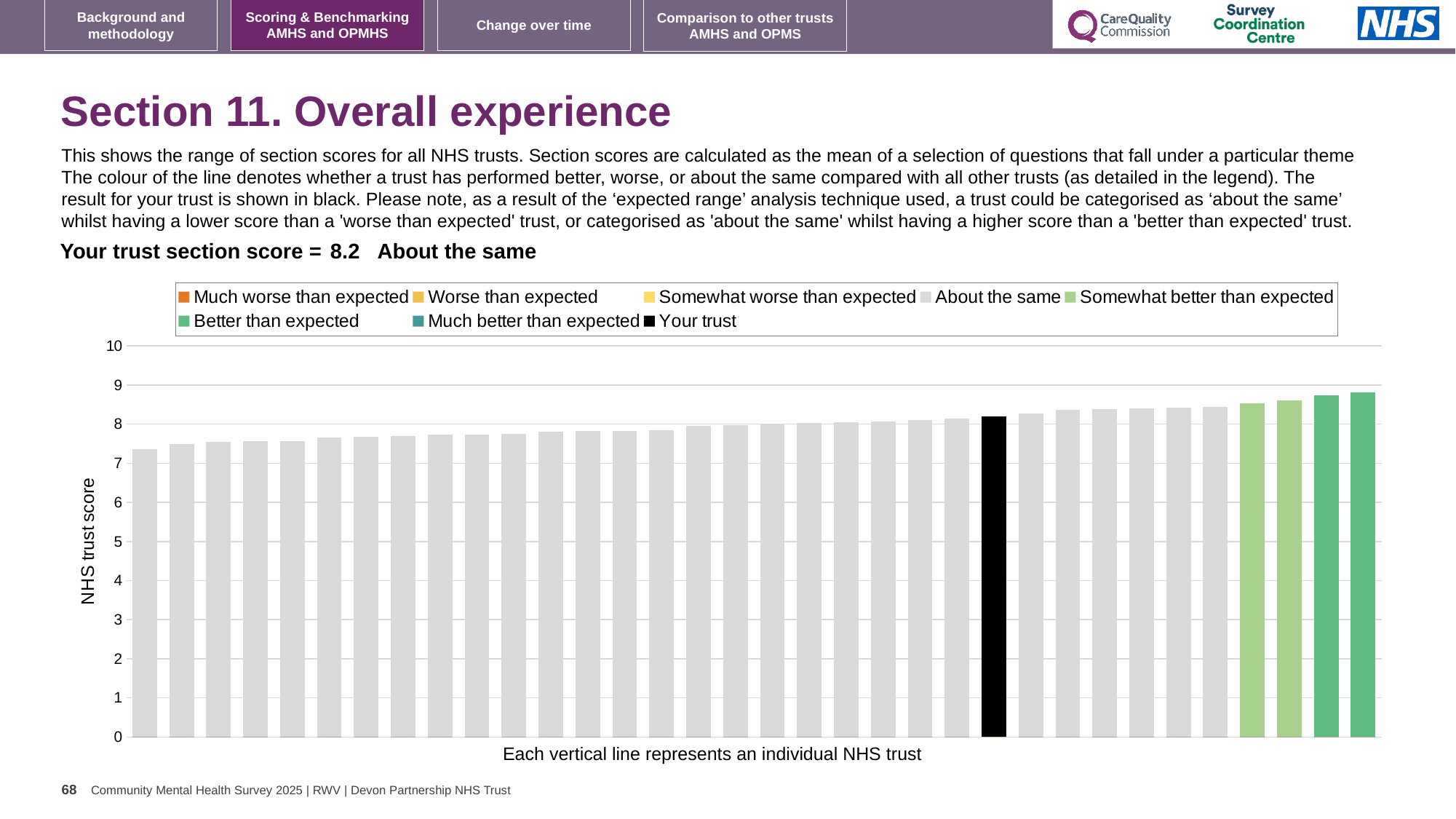
Is the value of the lowest bar (leftmost) greater or less than 7? greater What is the section score for your trust shown on the slide? 8.2 What is the label on the y axis of the chart? NHS trust score Is the value for your trust (the black bar) greater or less than 8? greater How many bars are coloured as 'Somewhat better than expected' (light green)? 2 Do the bar values rise or fall from left to right along the x axis? rise What colour is used for the bar representing your trust? Black Is the value of the highest bar (rightmost) greater or less than 9? less How many bars are coloured as 'Better than expected' (darker green)? 2 What kind of chart is shown on the slide? Bar chart How is your trust's section score categorised compared with other trusts? About the same How many entries does the legend list? 8